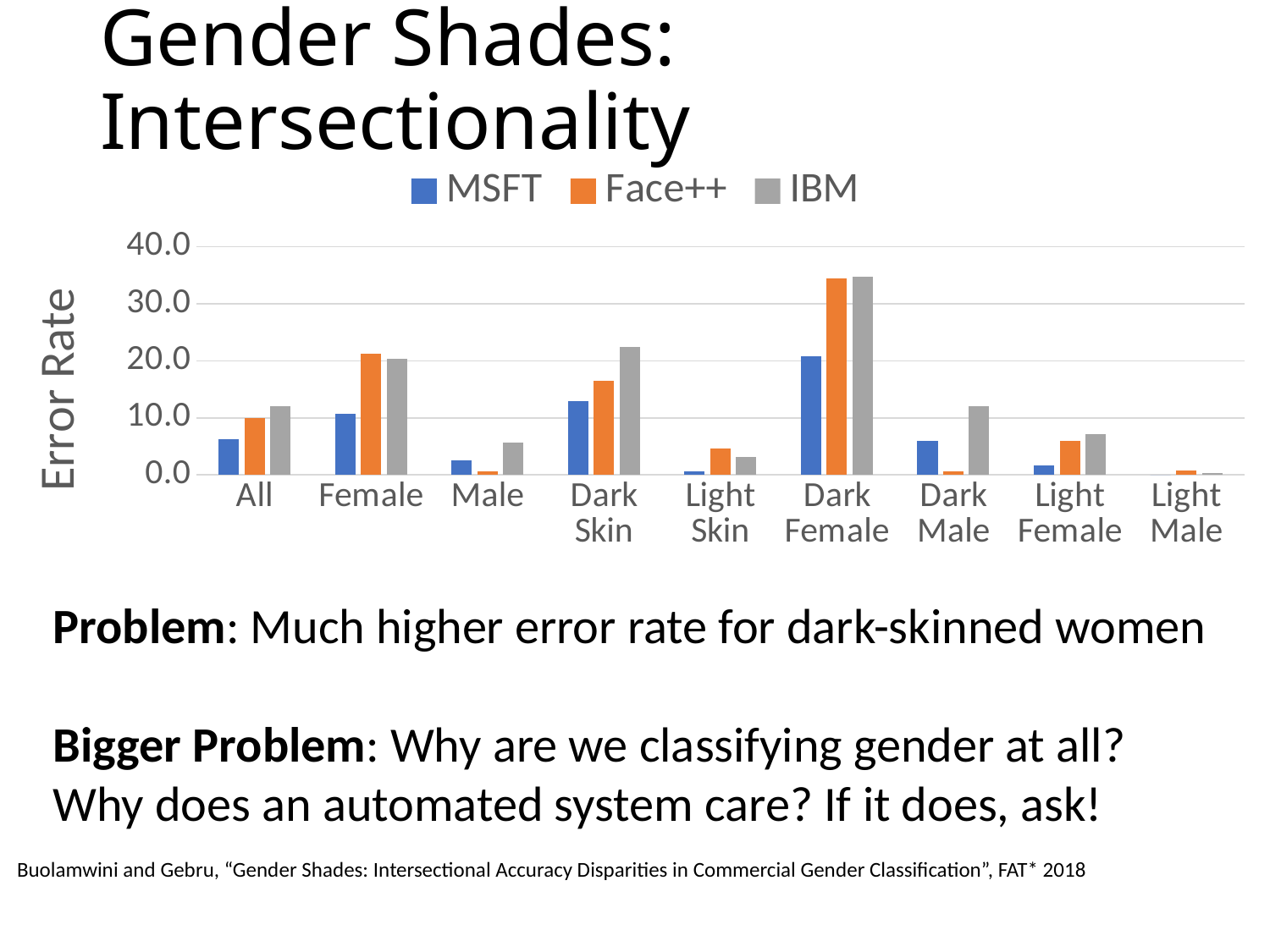
What is the label on the y axis? Error Rate Is the Face++ error rate for Dark Female greater or less than 30.0? greater Which series has the lowest error rate for Dark Male? Face++ How many series does the legend list? 3 For the Male category, which has the larger error rate, MSFT or IBM? IBM Is the MSFT error rate for All greater or less than 10.0? less What type of chart is shown on the slide? bar chart What colour represents Face++ in the legend? orange Is the IBM error rate for Dark Skin greater or less than 20.0? greater How many categories are shown along the x axis? 9 Which category has the highest IBM error rate? Dark Female For the Dark Skin category, which has the larger error rate, Face++ or IBM? IBM